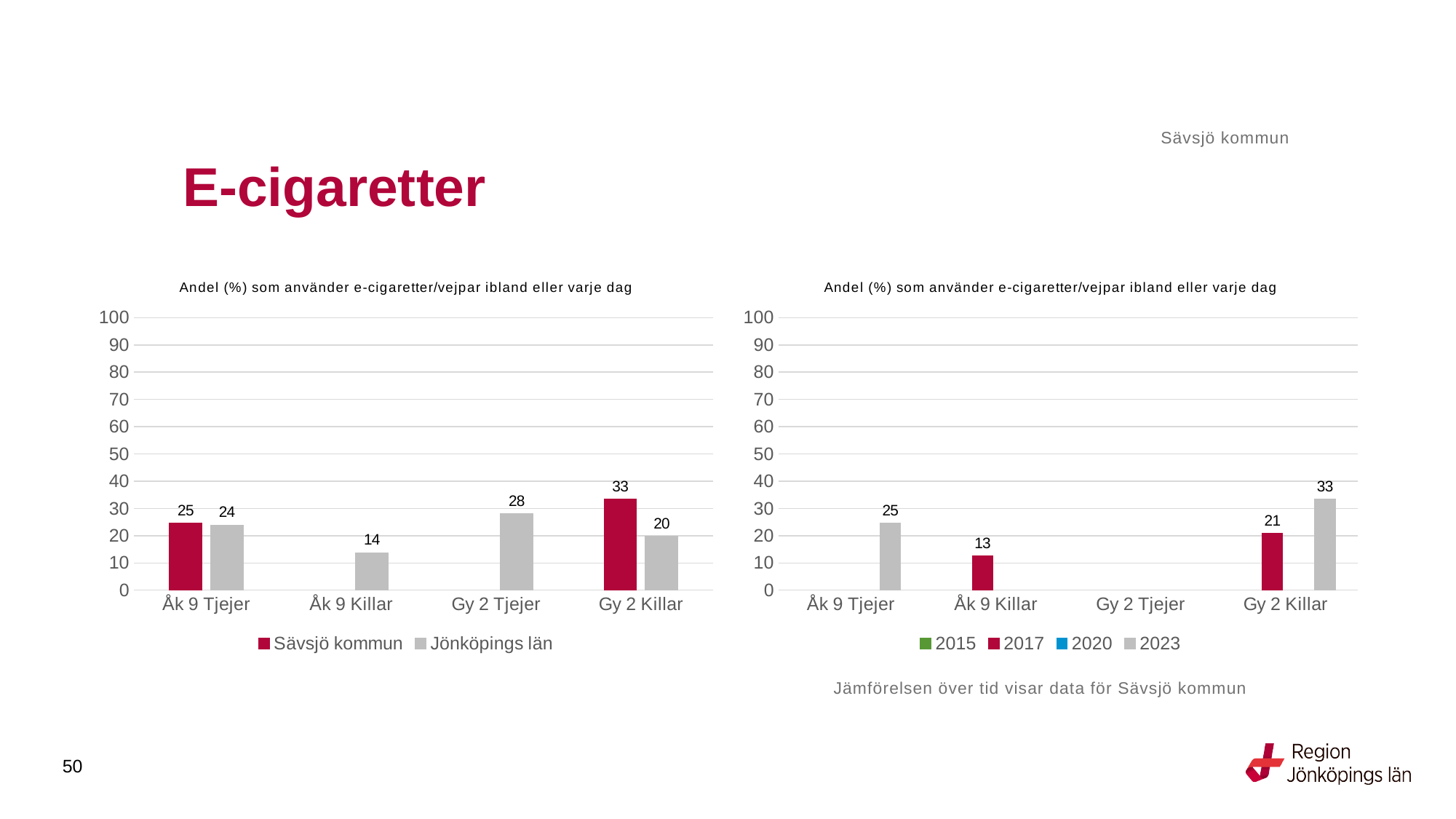
In the left chart, what is the value for Jönköpings län for Gy 2 Tjejer? 28 In the right chart, what is the difference between 2023 and 2017 for Gy 2 Killar? 12 In the right chart, what is the value for 2023 for Gy 2 Killar? 33 In the left chart, which category has the highest value for Jönköpings län? Gy 2 Tjejer In the right chart, what is the value for 2017 for Åk 9 Killar? 13 In the left chart, which is larger for Åk 9 Tjejer: Sävsjö kommun or Jönköpings län? Sävsjö kommun In the left chart, what is the difference between Sävsjö kommun and Jönköpings län for Gy 2 Killar? 13 In the right chart, how many series does the legend list? 4 In the left chart, what is the value for Sävsjö kommun for Åk 9 Tjejer? 25 In the left chart, how many series does the legend list? 2 What kind of chart is the left chart? Bar chart In the left chart, which category has the lowest value for Jönköpings län? Åk 9 Killar